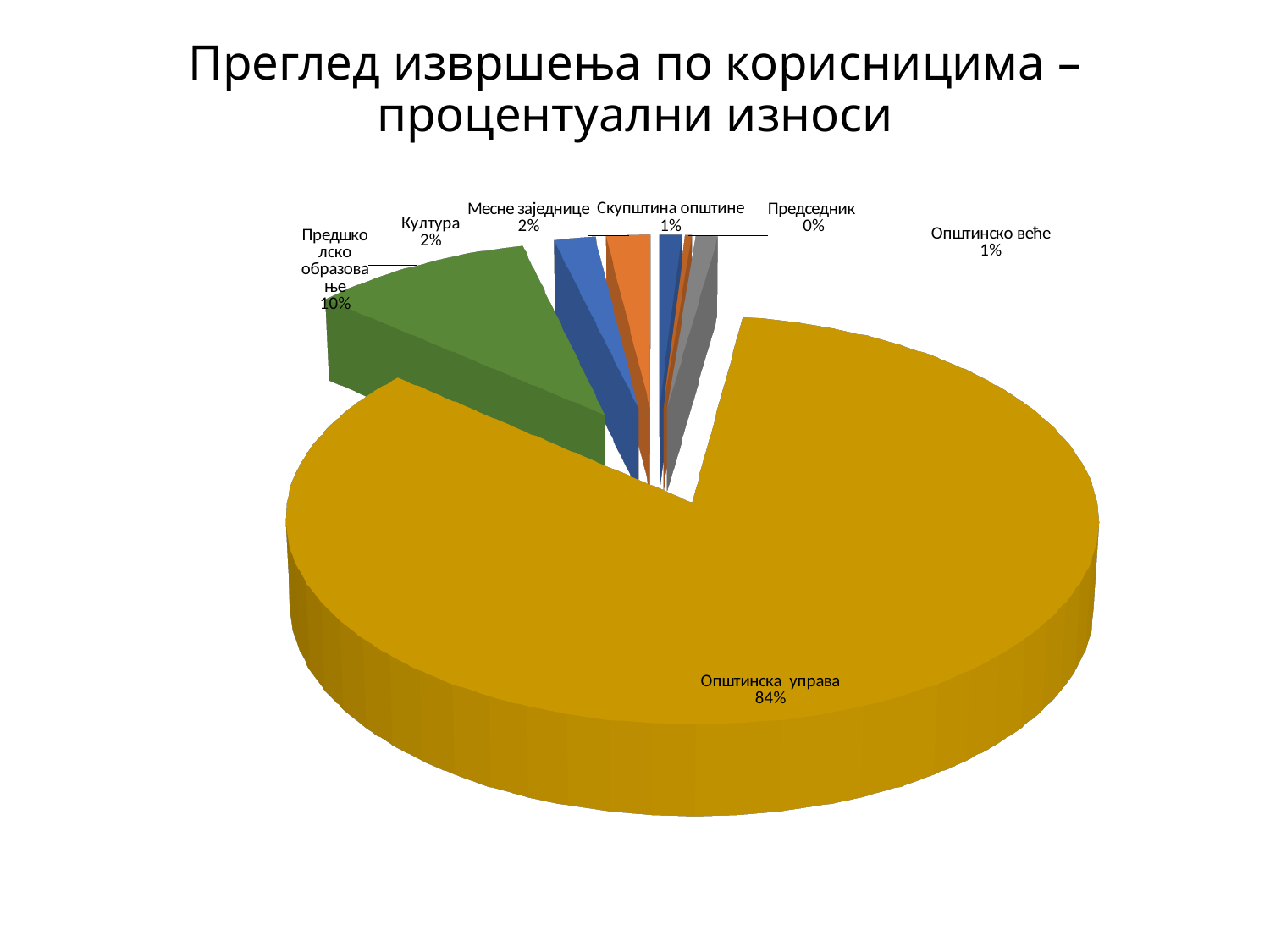
What is the value shown for Култура? 2% What share of the pie does Општинска управа have? 84% What is the value shown for Општинско веће? 1% How many categories are shown in the pie chart? 7 What is the title of the chart slide? Преглед извршења по корисницима – процентуални износи Which is larger, the share for Предшколско образовање or the share for Месне заједнице? Предшколско образовање Which category has the largest slice of the pie? Општинска управа What share of the pie does Предшколско образовање have? 10% What kind of chart is shown on the slide? pie chart What is the value shown for Председник? 0% Which category has the smallest slice of the pie? Председник What is the difference between the shares of Општинска управа and Предшколско образовање? 74%